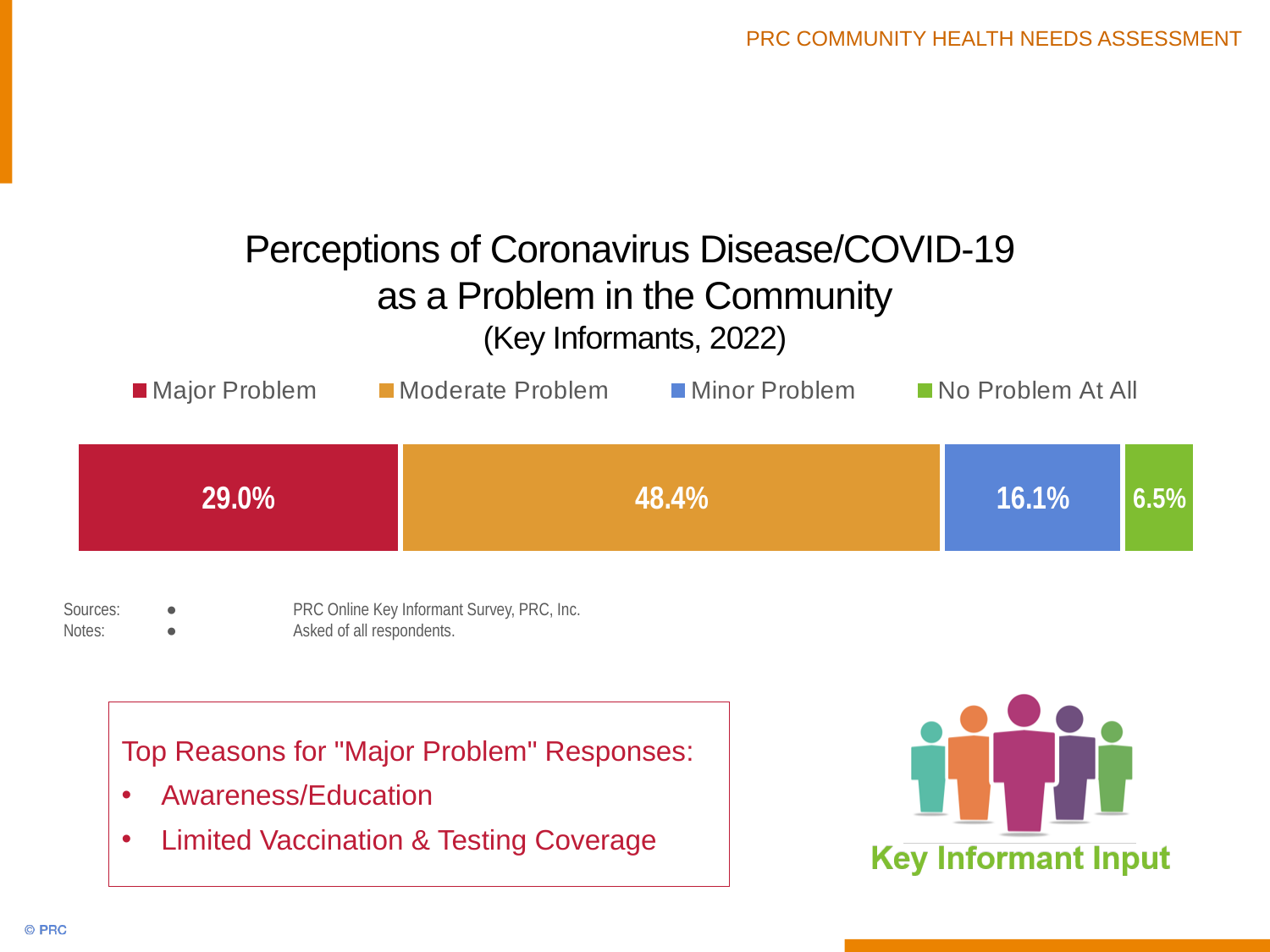
Which is larger: the "Major Problem" share or the "Minor Problem" share? Major Problem Which response category has the largest share in the chart? Moderate Problem What colour represents the "Minor Problem" segment in the chart? Blue How many response categories does the legend list? 4 What percentage of key informants said COVID-19 is "No Problem At All"? 6.5% What percentage of key informants rated COVID-19 a "Minor Problem"? 16.1% What kind of chart is shown on the slide? Stacked bar chart What is the combined percentage of "Major Problem" and "Moderate Problem" responses? 77.4% Which response category has the smallest share in the chart? No Problem At All What is the difference between the "Moderate Problem" and "Major Problem" percentages? 19.4% What percentage of key informants rated COVID-19 a "Moderate Problem"? 48.4% What percentage of key informants rated COVID-19 a "Major Problem"? 29.0%